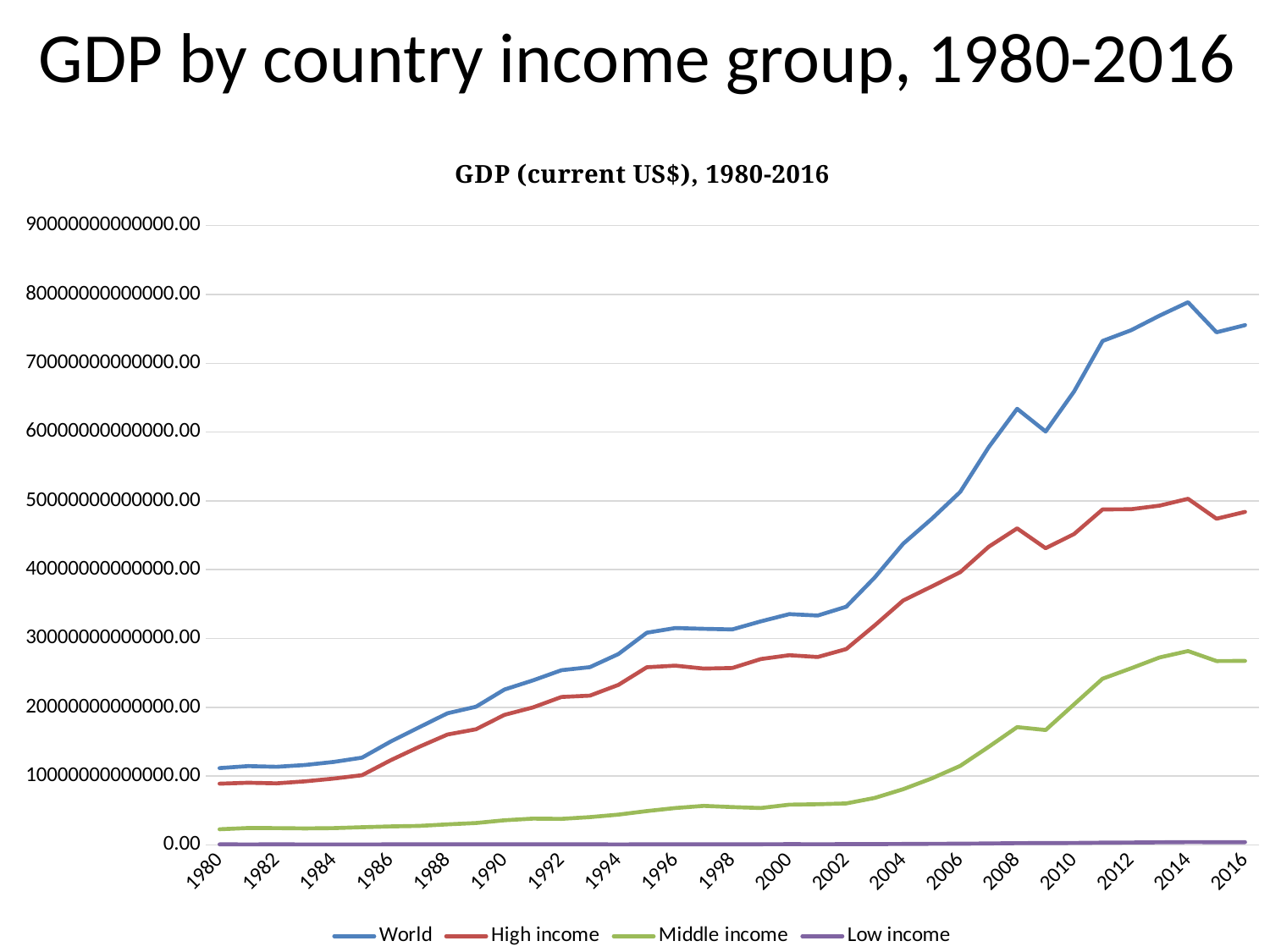
Which series has the lowest values across the chart? Low income Is the value for Middle income in 2016 greater or less than 300000000000000.00? less Is the value for World in 2016 greater or less than 700000000000000.00? greater Is the value for Middle income in 2008 greater or less than 100000000000000.00? greater What kind of chart is shown on the slide? line chart Which series has the highest values across the chart? World What is the title of the chart? GDP (current US$), 1980-2016 Does the World series rise or fall overall from 1980 to 2016? rise How many series does the legend list? 4 In 2016, which is larger: the value for High income or the value for Middle income? High income Which colour is used for the World series? blue